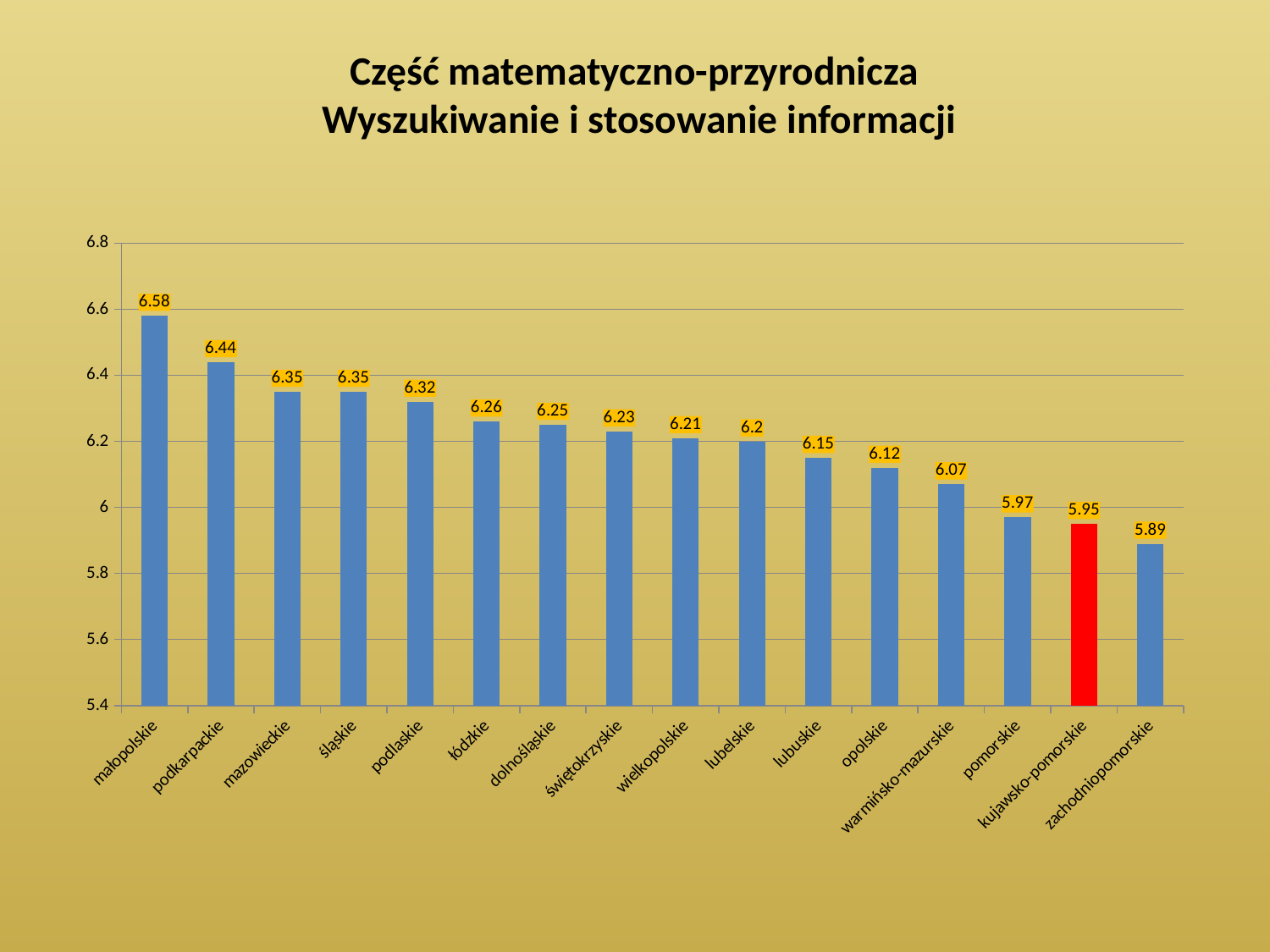
Which category has the highest value? małopolskie What is the value for małopolskie? 6.58 What kind of chart is shown on the slide? bar chart Which bar is coloured red instead of blue? kujawsko-pomorskie Is the value for pomorskie greater or less than 6? less What is the value for kujawsko-pomorskie? 5.95 What is the value for lubelskie? 6.2 Which category has the lowest value? zachodniopomorskie What is the difference between the values for małopolskie and zachodniopomorskie? 0.69 How many categories are shown on the x axis? 16 Do the values rise or fall from left to right along the x axis? fall Which is larger, the value for podkarpackie or the value for podlaskie? podkarpackie